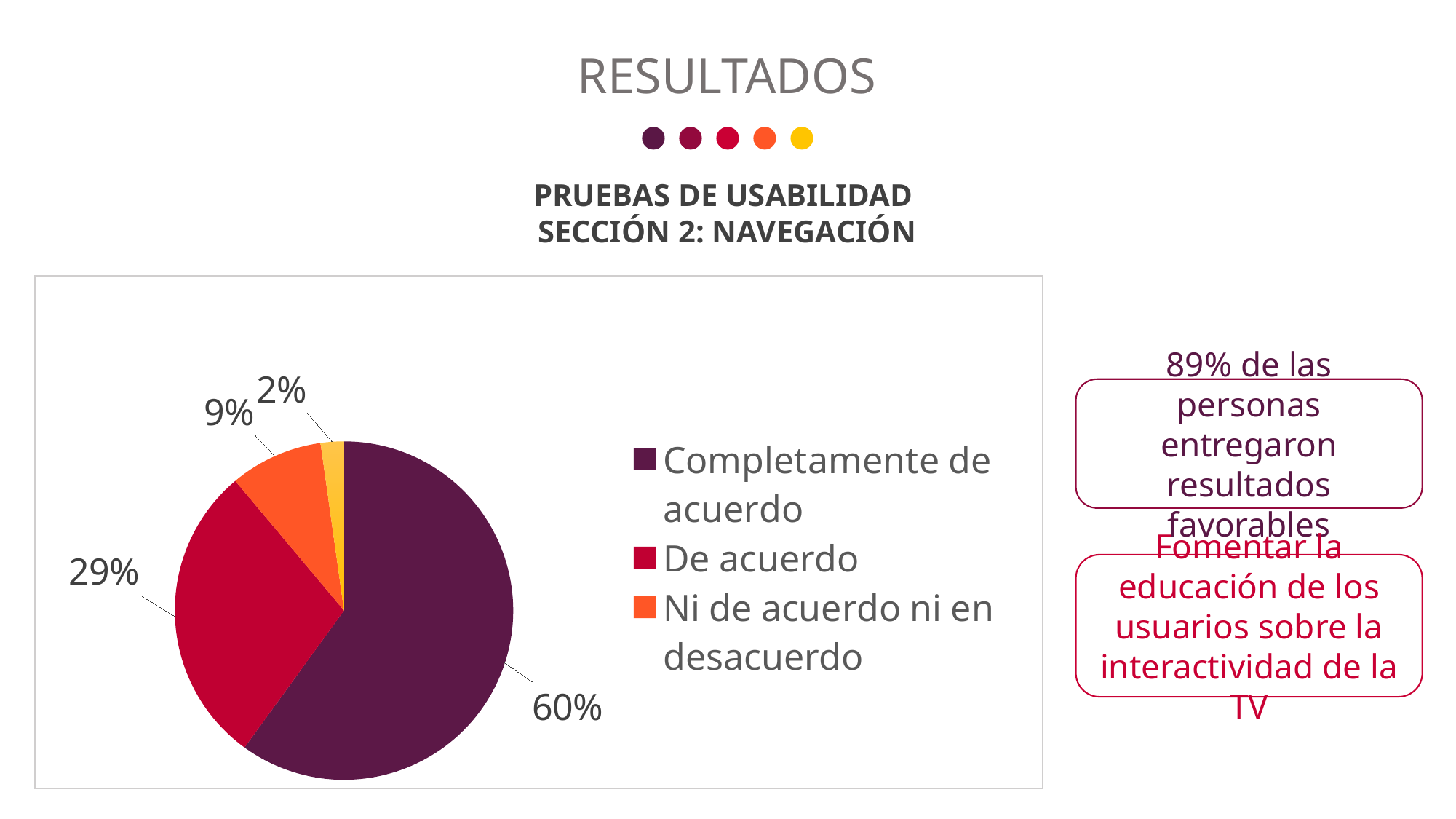
What kind of chart is shown on the slide? pie chart Which category has the largest share of the pie? Completamente de acuerdo How many entries does the chart legend list? 3 What percentage of the pie corresponds to "Ni de acuerdo ni en desacuerdo"? 9% What is the combined percentage of "Completamente de acuerdo" and "De acuerdo"? 89% What colour is the slice for "Ni de acuerdo ni en desacuerdo"? orange What percentage of the pie corresponds to "Completamente de acuerdo"? 60% What is the smallest percentage labelled on the pie chart? 2% How many slices does the pie chart have? 4 What percentage of the pie corresponds to "De acuerdo"? 29% Which is larger, the share for "De acuerdo" or the share for "Ni de acuerdo ni en desacuerdo"? De acuerdo What is the difference in percentage points between "Completamente de acuerdo" and "De acuerdo"? 31